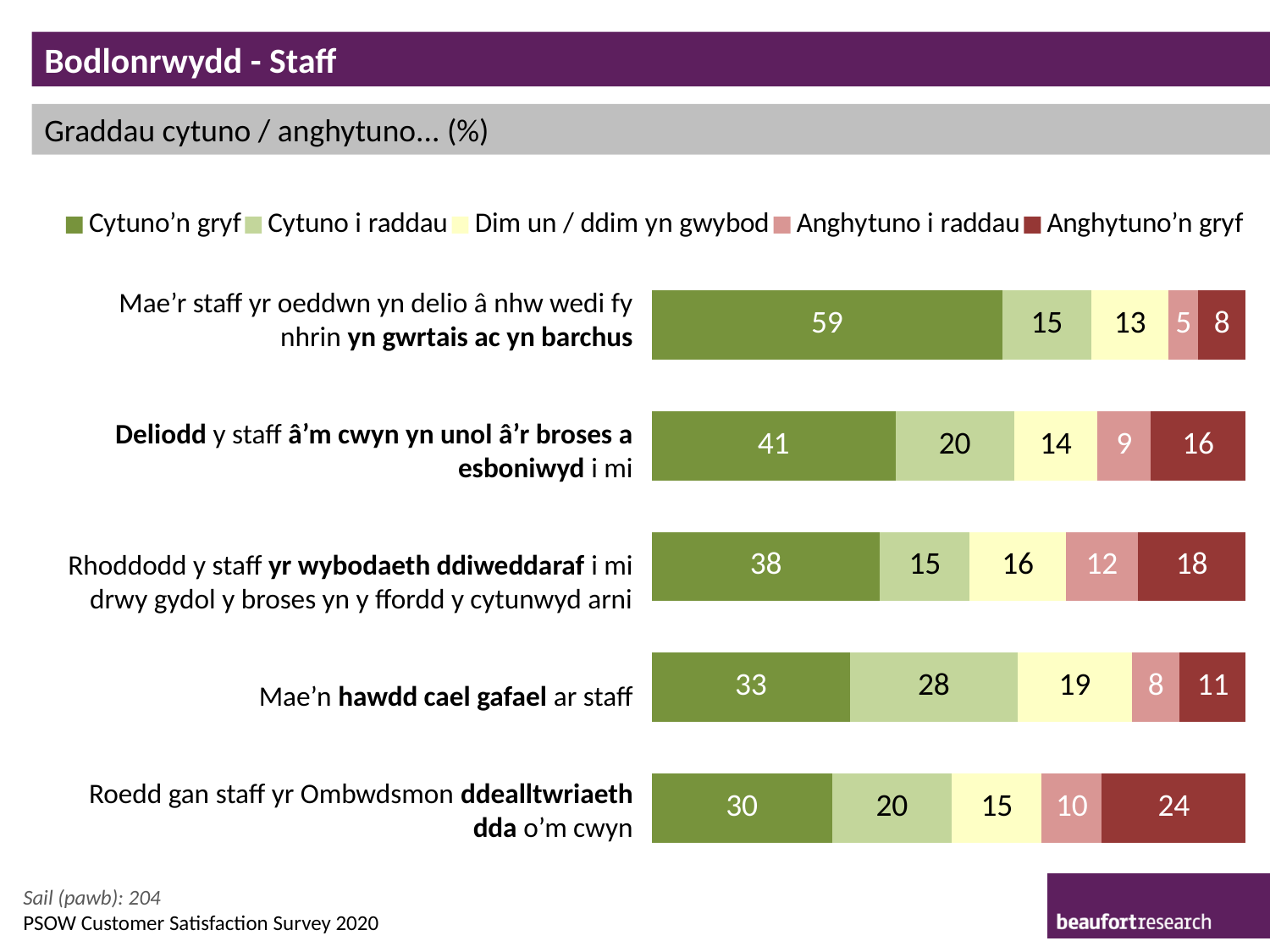
Which statement has the highest 'Cytuno'n gryf' value? Mae'r staff yr oeddwn yn delio â nhw wedi fy nhrin yn gwrtais ac yn barchus How many statements (categories) are plotted in the chart? 5 What is the 'Cytuno i raddau' value for 'Mae'n hawdd cael gafael ar staff'? 28 What is the difference between the 'Cytuno'n gryf' values for 'Deliodd y staff â'm cwyn yn unol â'r broses a esboniwyd i mi' and 'Rhoddodd y staff yr wybodaeth ddiweddaraf i mi drwy gydol y broses yn y ffordd y cytunwyd arni'? 3 What is the 'Anghytuno'n gryf' value for 'Roedd gan staff yr Ombwdsmon ddealltwriaeth dda o'm cwyn'? 24 How many series does the legend list? 5 Which is larger: the 'Anghytuno'n gryf' value for 'Deliodd y staff â'm cwyn yn unol â'r broses a esboniwyd i mi' or for 'Mae'n hawdd cael gafael ar staff'? Deliodd y staff â'm cwyn yn unol â'r broses a esboniwyd i mi What is the total of the stacked bar for 'Mae'n hawdd cael gafael ar staff'? 99 What is the 'Anghytuno i raddau' value for 'Rhoddodd y staff yr wybodaeth ddiweddaraf i mi drwy gydol y broses yn y ffordd y cytunwyd arni'? 12 Which statement has the lowest 'Cytuno'n gryf' value? Roedd gan staff yr Ombwdsmon ddealltwriaeth dda o'm cwyn What is the 'Cytuno'n gryf' value for the statement 'Mae'r staff yr oeddwn yn delio â nhw wedi fy nhrin yn gwrtais ac yn barchus'? 59 What type of chart is shown on the slide? Stacked bar chart